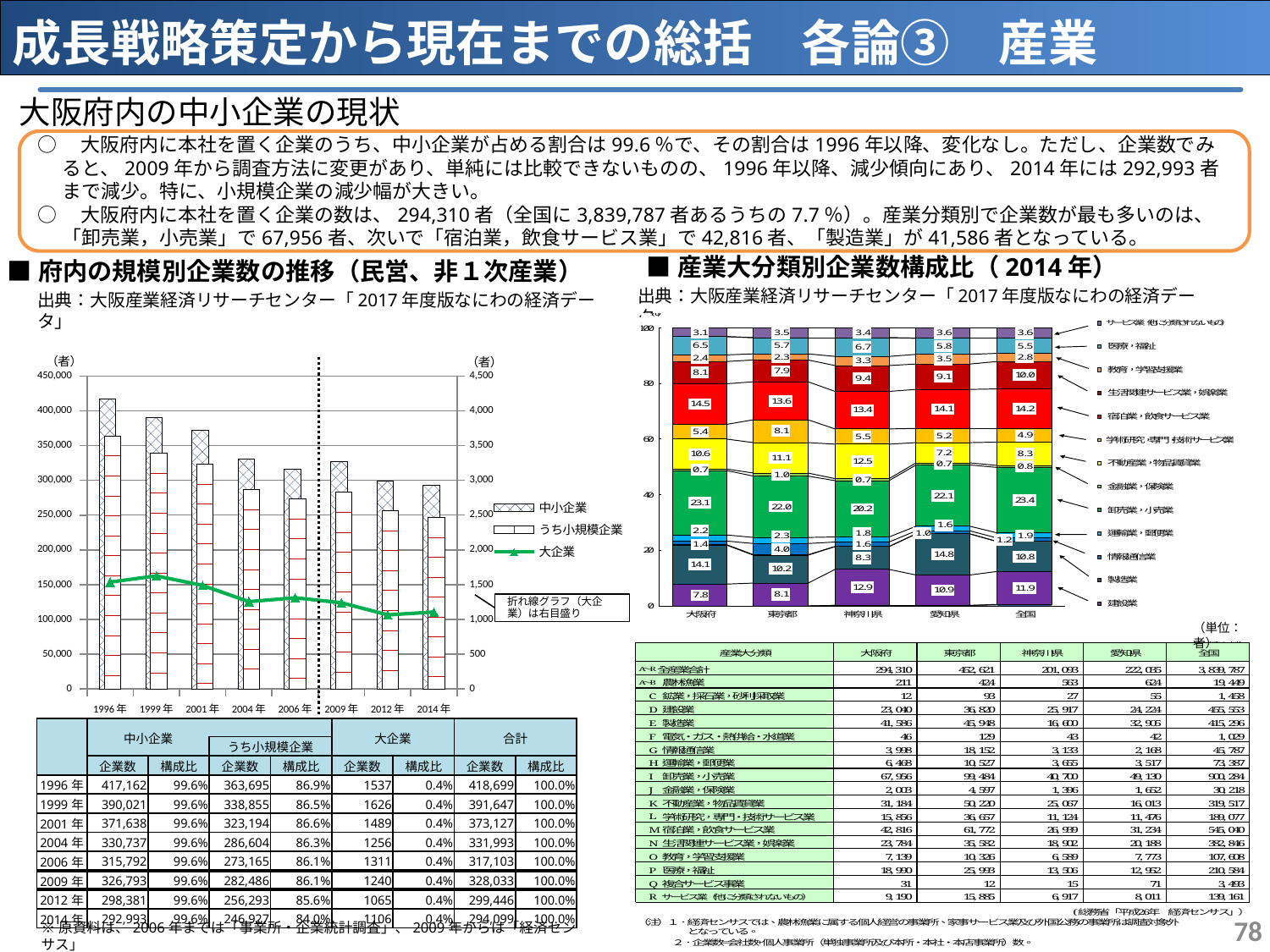
What kind of chart is the right-hand chart titled 産業大分類別企業数構成比（2014年）? stacked bar chart In the chart 産業大分類別企業数構成比（2014年）, how many regions are shown along the x axis? 5 In the chart 産業大分類別企業数構成比（2014年）, is the 宿泊業・飲食サービス業 segment larger for 大阪府 or for 東京都? 大阪府 In the chart 府内の規模別企業数の推移（民営、非１次産業）, do the 中小企業 bars generally rise or fall from 1996年 to 2014年? fall In the chart 府内の規模別企業数の推移（民営、非１次産業）, is the 中小企業 bar for 1996年 greater or less than 400,000? greater What kind of chart is the left-hand chart titled 府内の規模別企業数の推移（民営、非１次産業）? bar chart with a line In the chart 府内の規模別企業数の推移（民営、非１次産業）, how many years are shown along the x axis? 8 In the chart 産業大分類別企業数構成比（2014年）, which region has the largest 建設業 (bottom) segment? 神奈川県 In the chart 産業大分類別企業数構成比（2014年）, what is the difference between the 卸売業・小売業 segment for 全国 and for 神奈川県? 3.2 In the chart 産業大分類別企業数構成比（2014年）, what is the value of the 製造業 segment for 大阪府? 14.1 In the chart 産業大分類別企業数構成比（2014年）, what is the value of the 卸売業・小売業 segment for 大阪府? 23.1 In the chart 産業大分類別企業数構成比（2014年）, how many industry categories does the legend list? 13